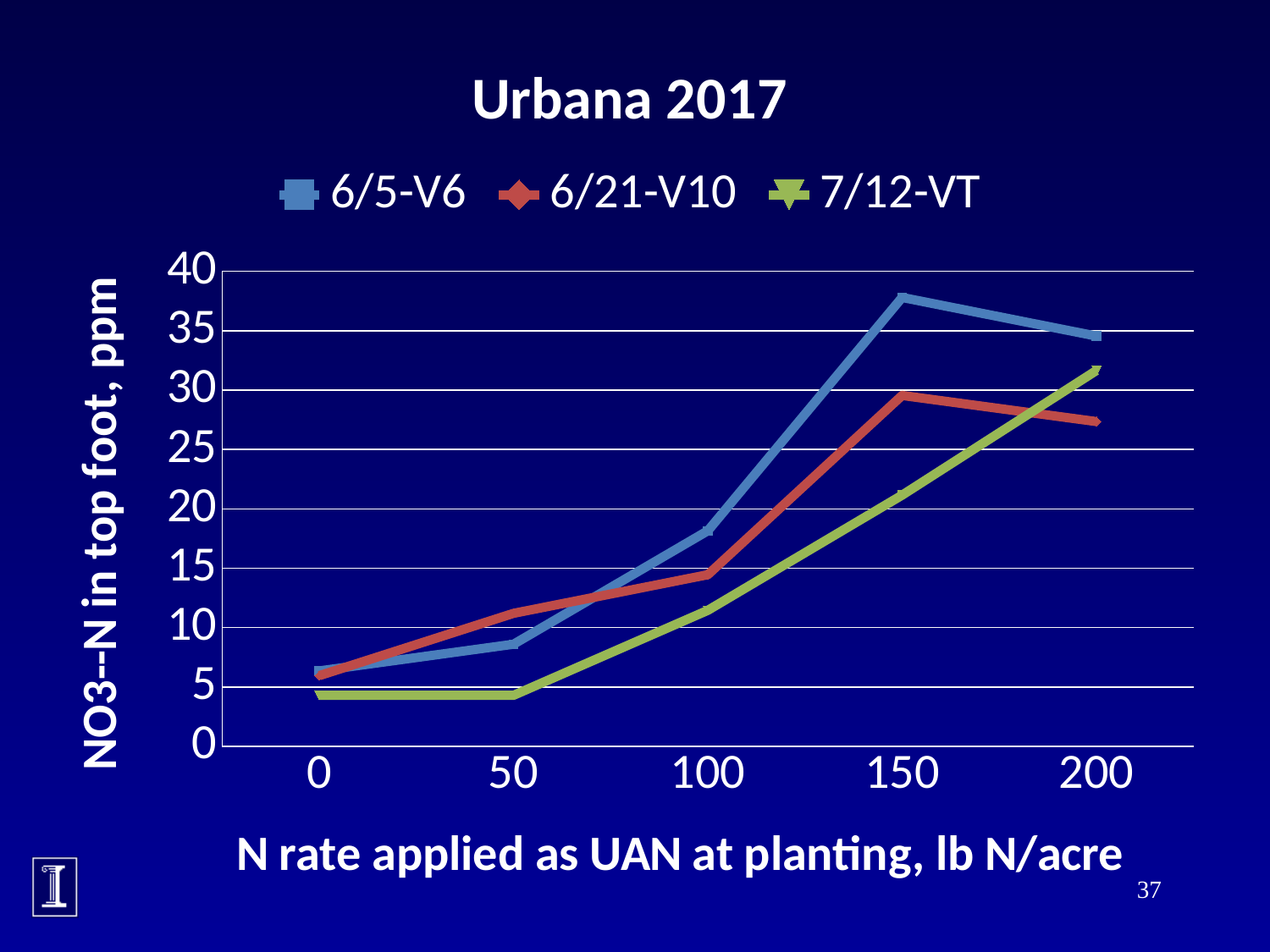
How many N rate values are plotted along the x axis? 5 At which N rate does the 6/5-V6 series reach its highest value? 150 Is the value for 7/12-VT at an N rate of 0 greater or less than 5? less What kind of chart is shown on the slide? line chart How many series does the legend list? 3 Is the value for 6/5-V6 at an N rate of 150 greater or less than 35? greater At which N rate does the 7/12-VT series reach its highest value? 200 What is the title of the chart? Urbana 2017 At an N rate of 200, which series has the larger value, 6/5-V6 or 6/21-V10? 6/5-V6 Is the value for 6/21-V10 at an N rate of 150 greater or less than 25? greater At an N rate of 200, which series has the larger value, 7/12-VT or 6/21-V10? 7/12-VT